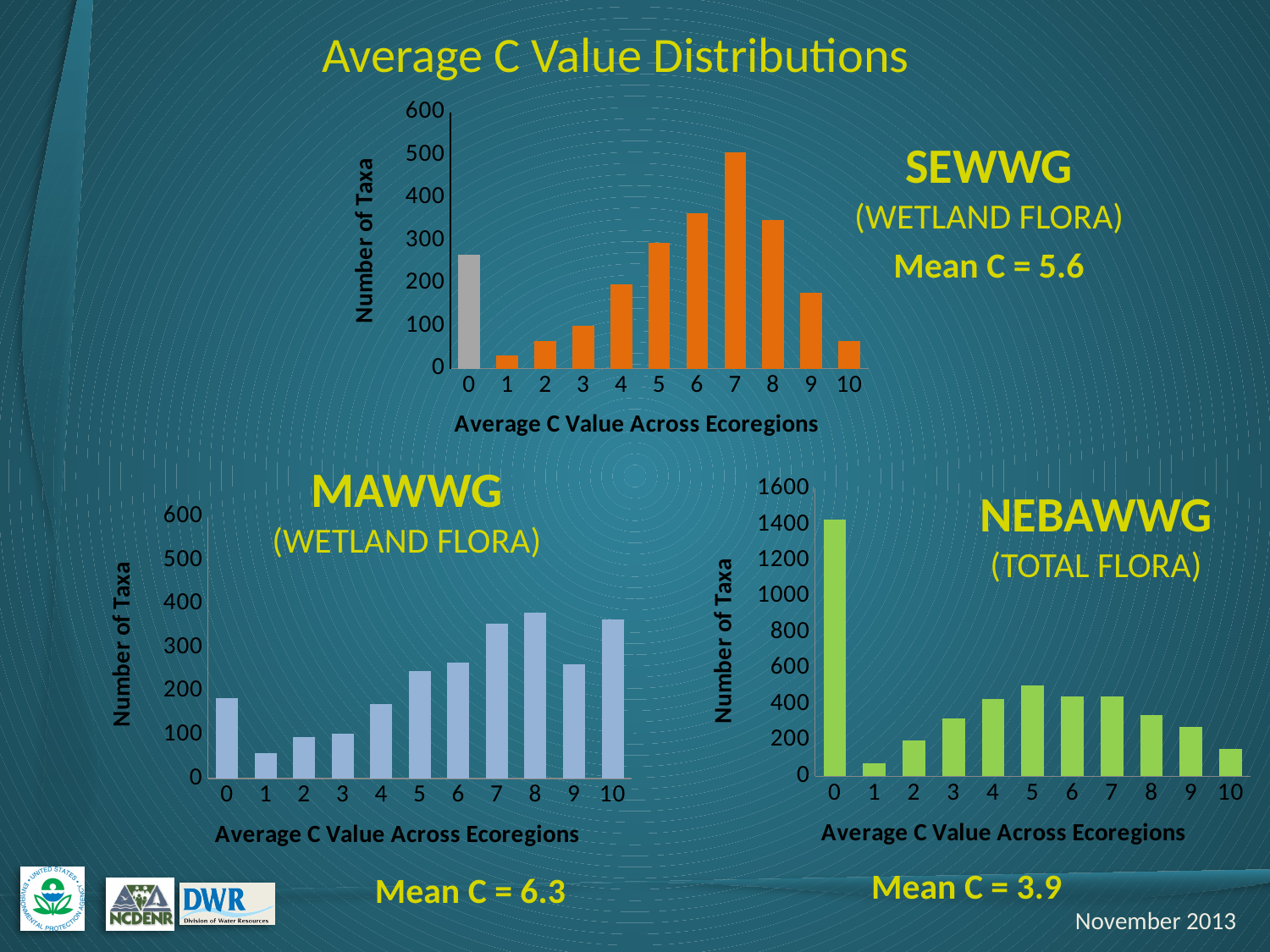
How many average C value categories are shown on the x axis of the MAWWG (Wetland Flora) chart? 11 In the NEBAWWG (Total Flora) chart, which average C value has the highest number of taxa? 0 In the NEBAWWG (Total Flora) chart, do the number of taxa rise or fall from average C value 5 to average C value 10? fall In the NEBAWWG (Total Flora) chart, which has more taxa: average C value 5 or average C value 10? 5 What Mean C value is stated for the NEBAWWG (Total Flora) chart? 3.9 What kind of chart is the SEWWG (Wetland Flora) chart? bar chart In the MAWWG (Wetland Flora) chart, which average C value has the highest number of taxa? 8 In the SEWWG (Wetland Flora) chart, which average C value has the lowest number of taxa? 1 In the MAWWG (Wetland Flora) chart, is the number of taxa for average C value 5 greater or less than 200? greater In the MAWWG (Wetland Flora) chart, which average C value has the lowest number of taxa? 1 In the SEWWG (Wetland Flora) chart, is the number of taxa for average C value 0 greater or less than 200? greater In the SEWWG (Wetland Flora) chart, which average C value has the highest number of taxa? 7